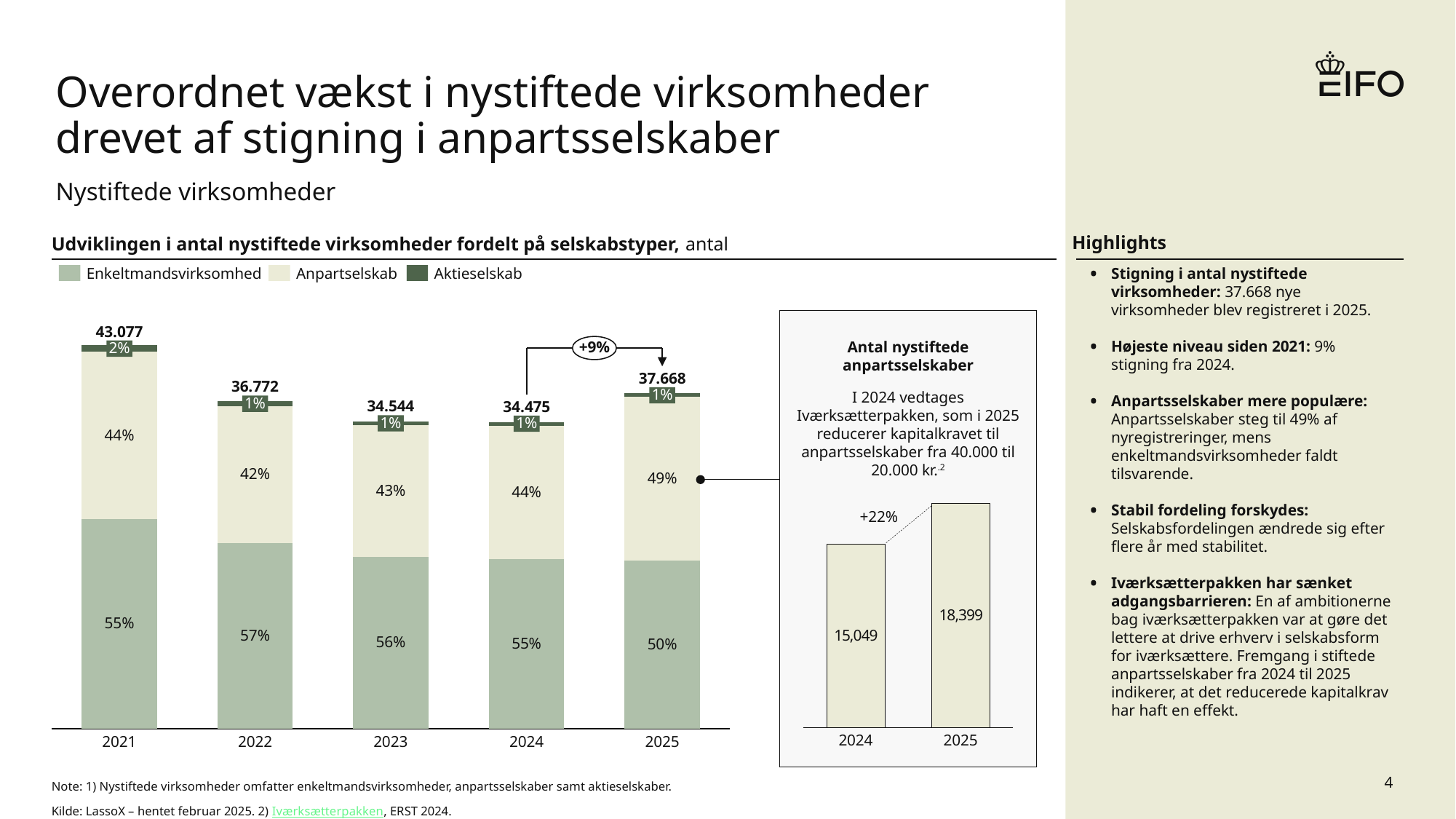
In the chart 'Udviklingen i antal nystiftede virksomheder fordelt på selskabstyper', what is the difference between the 2021 total and the 2022 total? 6.305 In the inset chart 'Antal nystiftede anpartsselskaber', what is the value for 2024? 15,049 In the chart 'Udviklingen i antal nystiftede virksomheder fordelt på selskabstyper', which year has the lowest total? 2024 In the inset chart 'Antal nystiftede anpartsselskaber', what is the difference between the 2025 and 2024 values? 3,350 In the chart 'Udviklingen i antal nystiftede virksomheder fordelt på selskabstyper', how many years are shown on the x axis? 5 In the chart 'Udviklingen i antal nystiftede virksomheder fordelt på selskabstyper', which year has the highest total? 2021 In the chart 'Udviklingen i antal nystiftede virksomheder fordelt på selskabstyper', what share does Anpartsselskab have in 2025? 49% What kind of chart is 'Udviklingen i antal nystiftede virksomheder fordelt på selskabstyper'? Stacked bar chart In the chart 'Udviklingen i antal nystiftede virksomheder fordelt på selskabstyper', is the Enkeltmandsvirksomhed share larger in 2022 or in 2025? 2022 In the chart 'Udviklingen i antal nystiftede virksomheder fordelt på selskabstyper', what is the total number of newly founded companies in 2025? 37.668 In the chart 'Udviklingen i antal nystiftede virksomheder fordelt på selskabstyper', how many series does the legend list? 3 In the chart 'Udviklingen i antal nystiftede virksomheder fordelt på selskabstyper', does the Anpartsselskab share rise or fall from 2022 to 2025? Rise